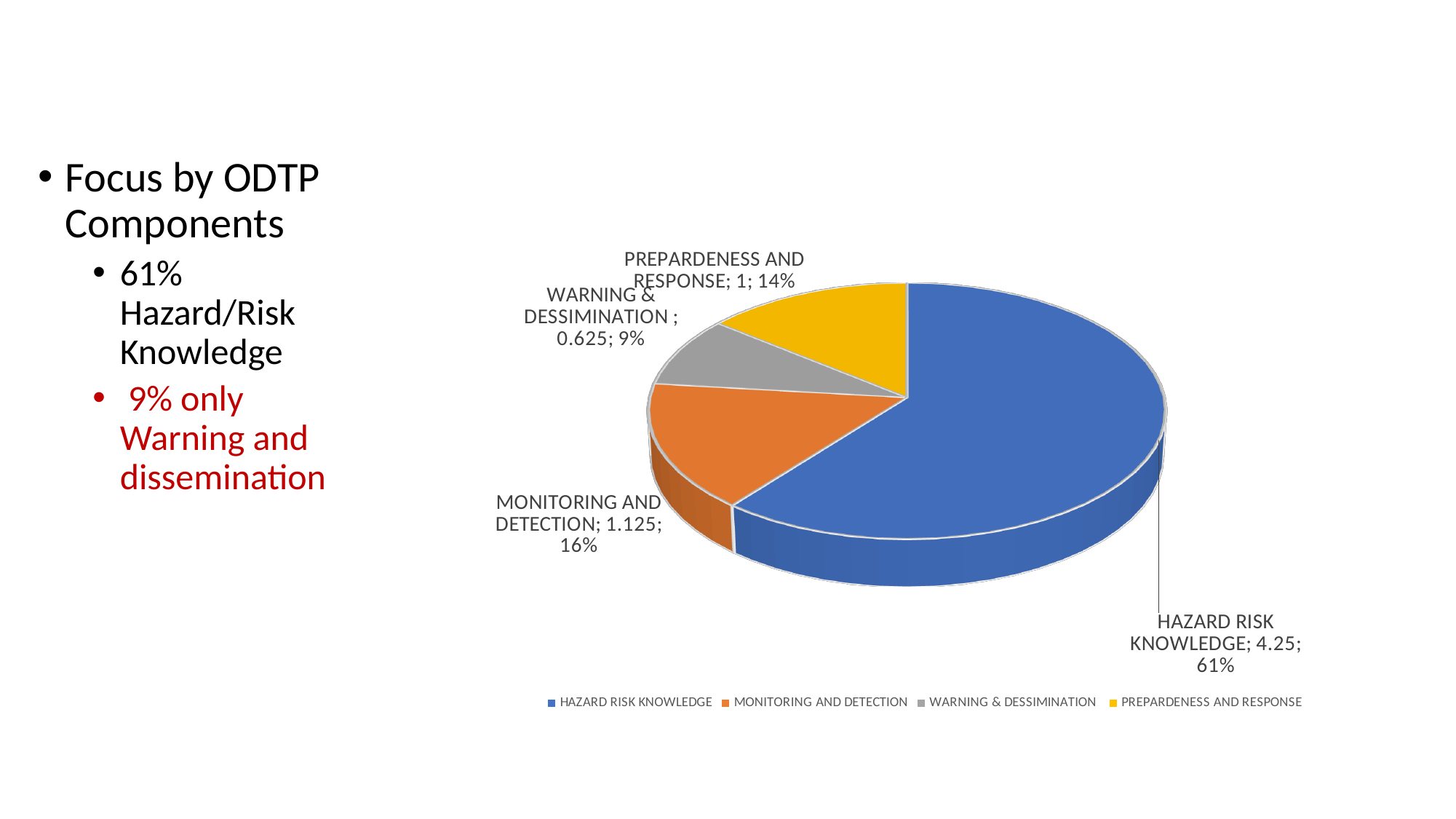
What is the value for PREPARDENESS AND RESPONSE? 1 Which category has the smallest slice of the pie? WARNING & DESSIMINATION What is the difference between the values for HAZARD RISK KNOWLEDGE and MONITORING AND DETECTION? 3.125 What is the value for WARNING & DESSIMINATION? 0.625 What is the value for MONITORING AND DETECTION? 1.125 What share of the pie does PREPARDENESS AND RESPONSE represent? 14% What share of the pie does MONITORING AND DETECTION represent? 16% What is the value for HAZARD RISK KNOWLEDGE? 4.25 What kind of chart is shown on the slide? pie chart Which is larger, the value for PREPARDENESS AND RESPONSE or the value for WARNING & DESSIMINATION? PREPARDENESS AND RESPONSE Which category has the largest slice of the pie? HAZARD RISK KNOWLEDGE How many slices does the pie chart have? 4